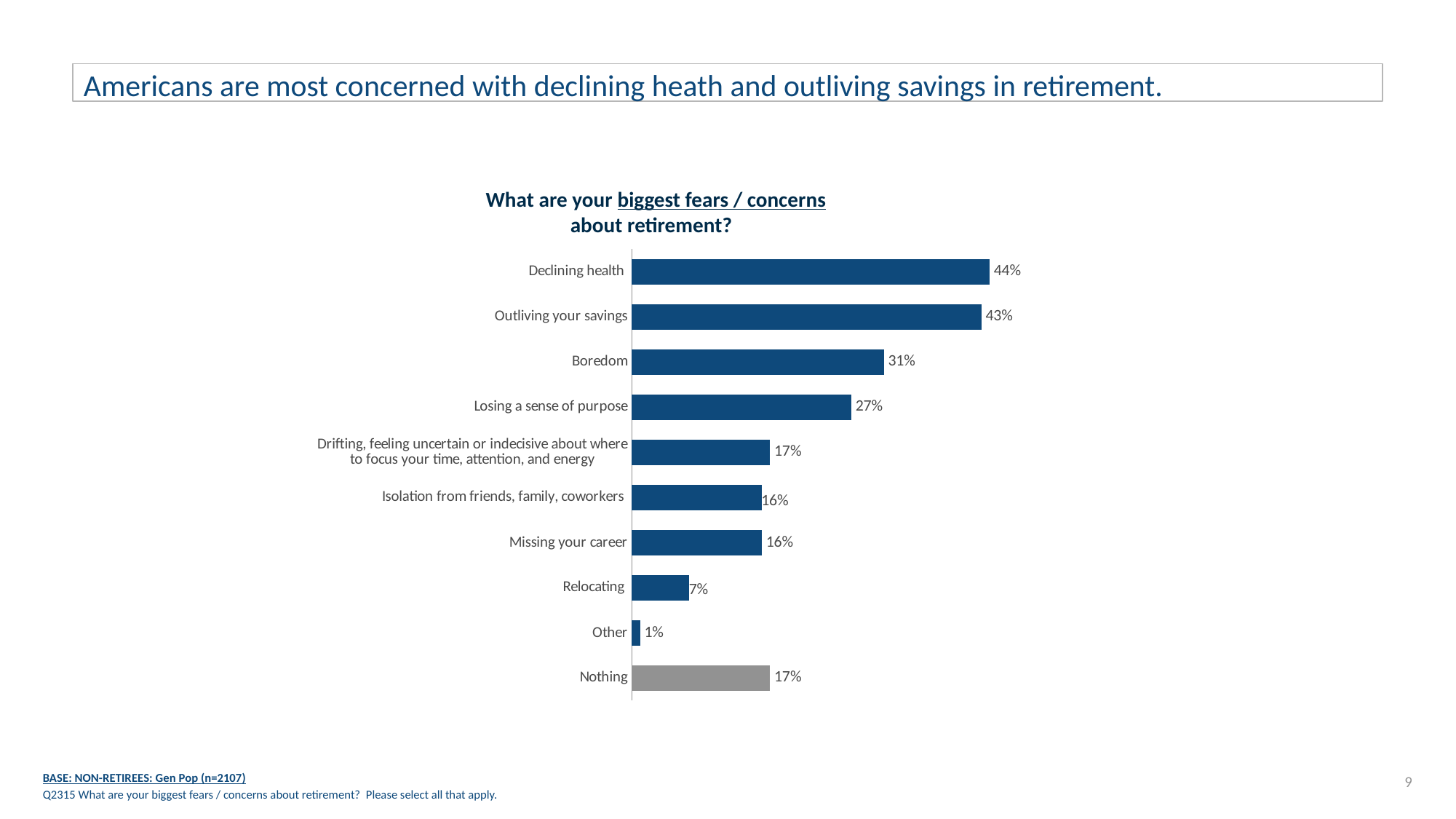
How many categories are shown in the chart? 10 What percentage of respondents selected Nothing? 17% What percentage of respondents cited Declining health as a fear or concern about retirement? 44% Which category has the lowest value in the chart? Other What percentage is shown for Boredom? 31% Which is larger, the value for Relocating or the value for Missing your career? Missing your career What is the value for Losing a sense of purpose? 27% What is the difference between the values for Boredom and Losing a sense of purpose? 4% Which bar in the chart is coloured grey rather than dark blue? Nothing What is the value shown for Outliving your savings? 43% Which category has the highest value in the chart? Declining health What kind of chart is shown on the slide? Bar chart